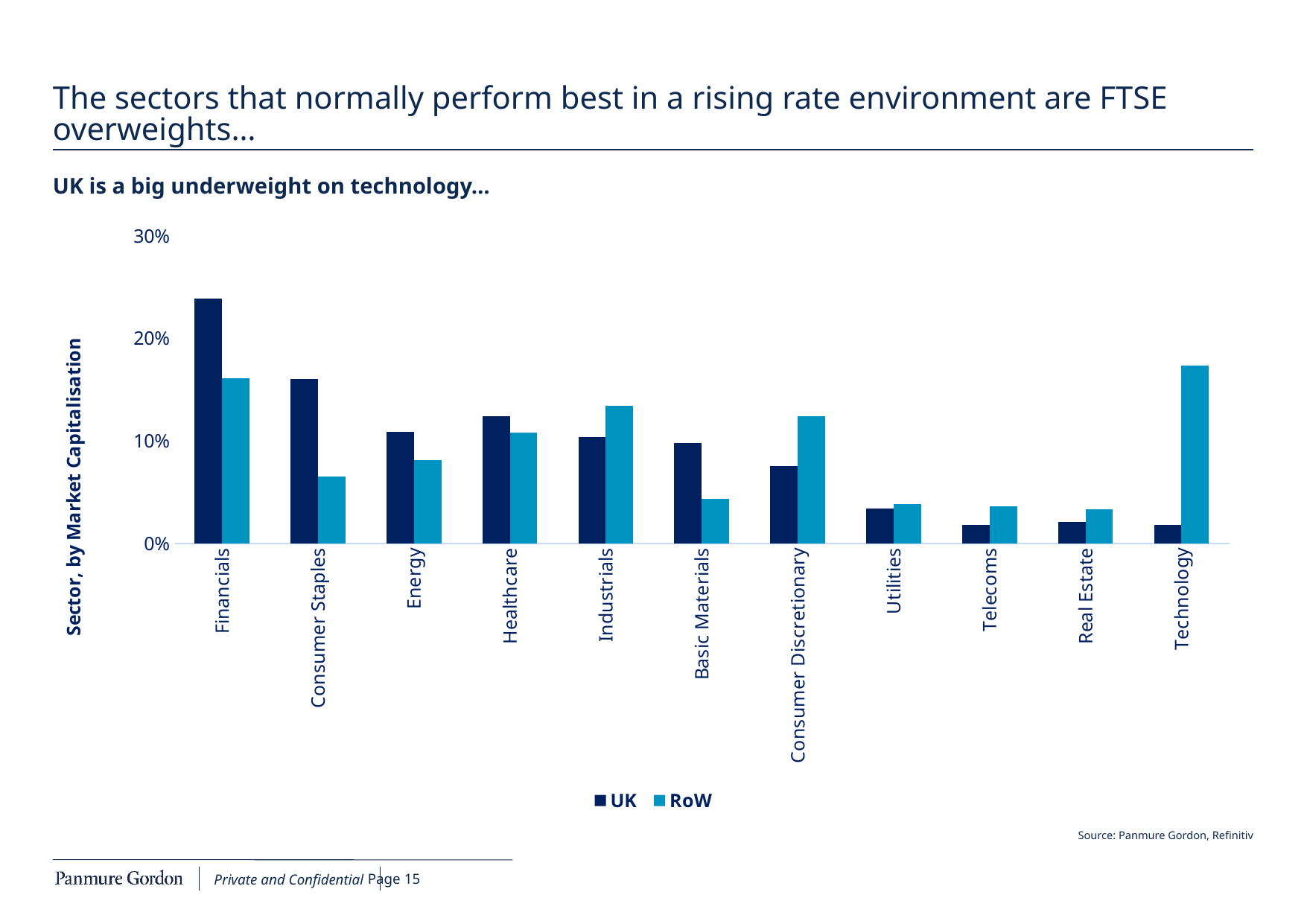
Which sector has the highest RoW value? Technology For Technology, which series has the larger value, UK or RoW? RoW For Consumer Staples, which series has the larger value, UK or RoW? UK Is the RoW value for Consumer Staples greater or less than 10%? less How many sectors are shown on the x axis of the chart? 11 What kind of chart is shown on the slide? Bar chart Is the RoW value for Technology greater or less than 10%? greater Which sector has the highest UK value? Financials Is the UK value for Financials greater or less than 20%? greater How many series does the chart's legend list? 2 What is the title of the chart's vertical axis? Sector, by Market Capitalisation